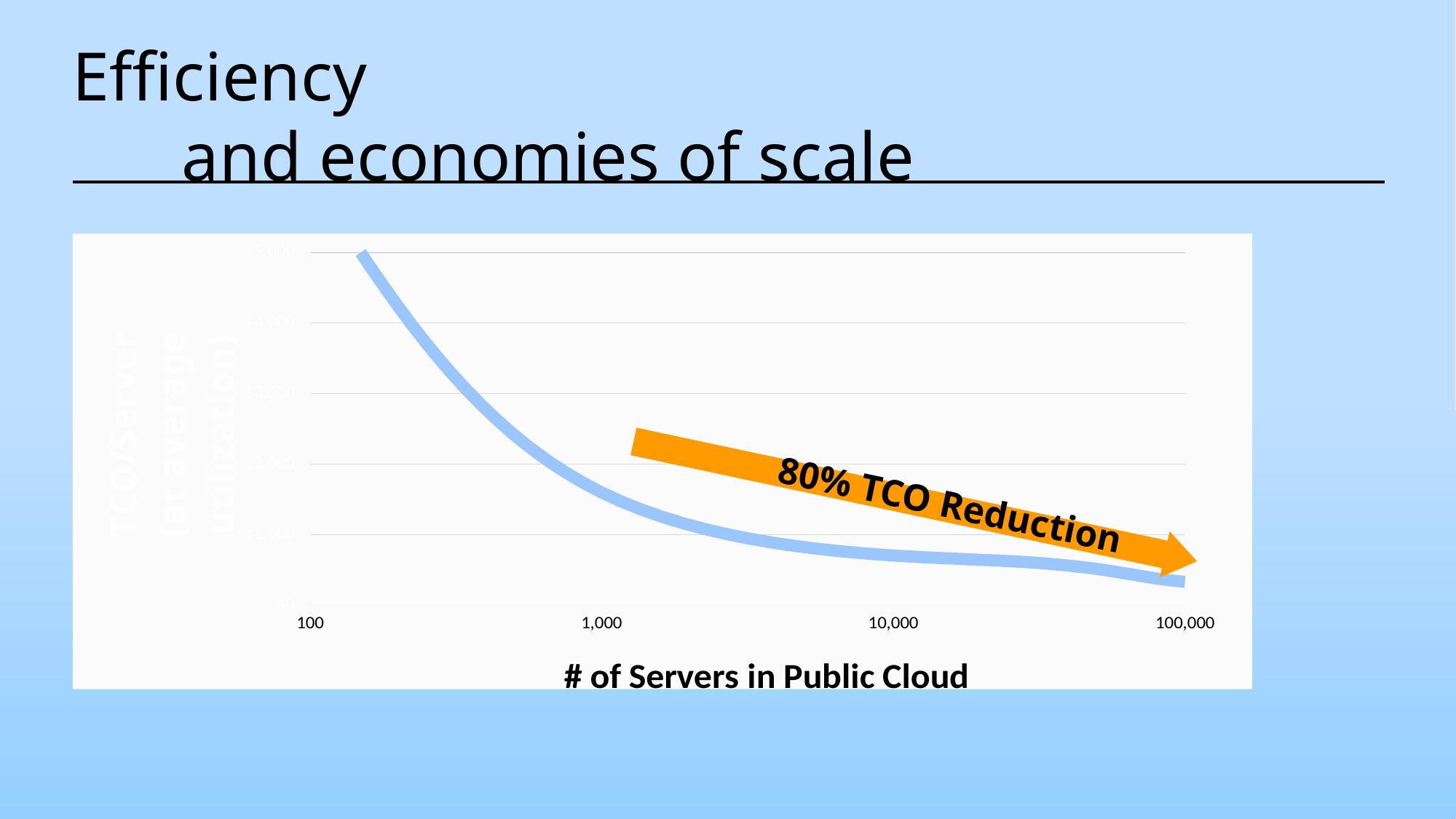
Do the values on the chart rise or fall as the number of servers increases along the x axis? fall What is the title of the x axis of the chart? # of Servers in Public Cloud Which is larger on the chart: the value at 1,000 servers or the value at 100,000 servers? 1,000 servers How many tick labels are shown on the x axis of the chart? 4 What kind of chart is shown on the slide? line chart Which is larger on the chart: the value at 100 servers or the value at 10,000 servers? 100 servers What text is written on the orange arrow overlaid on the chart? 80% TCO Reduction What is the largest x-axis tick label shown on the chart? 100,000